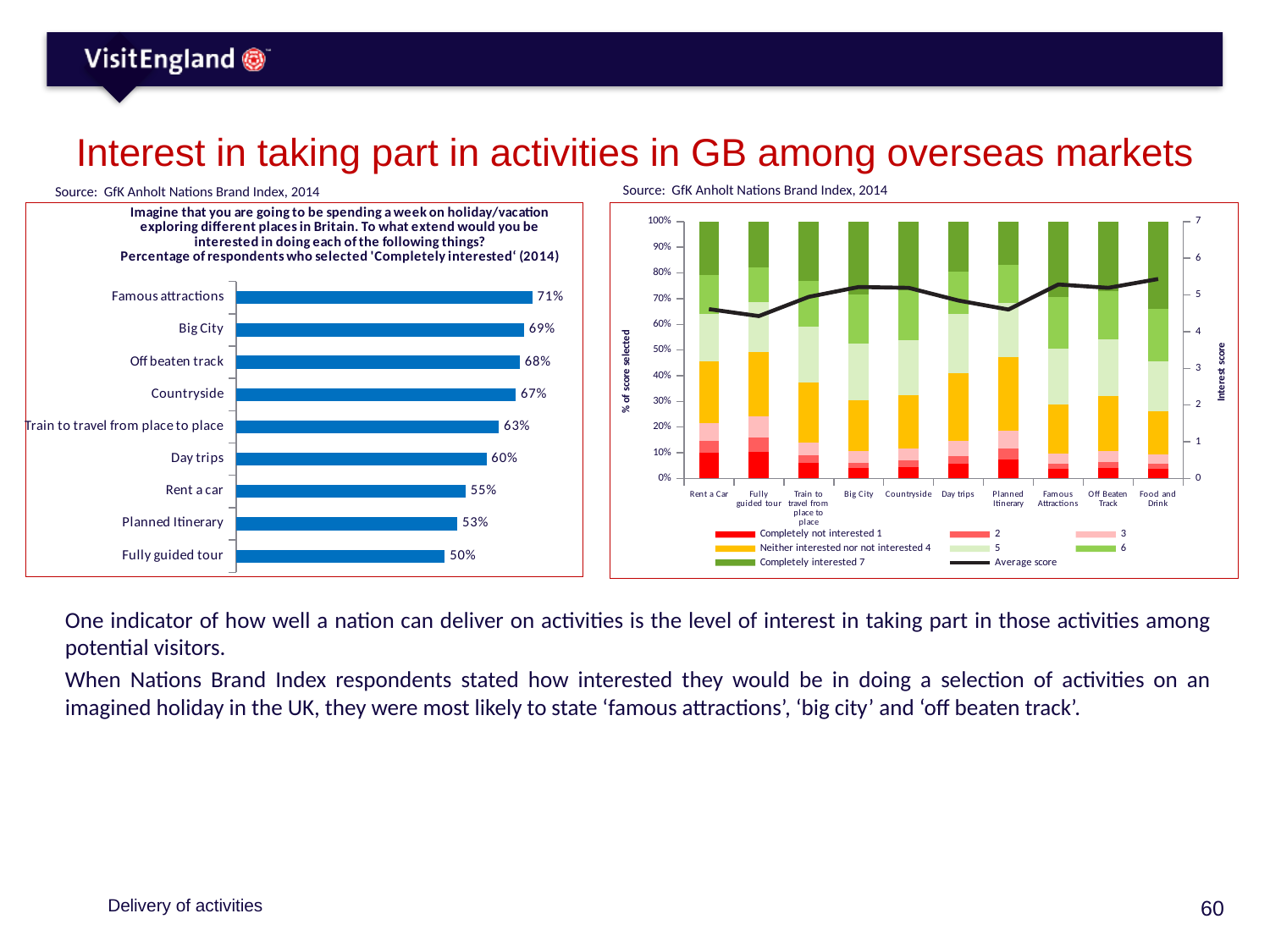
On the left chart, which is larger: the value for Day trips or the value for Planned Itinerary? Day trips On the right chart, is the Average score for Food and Drink greater or less than 5? greater On the left chart, what is the value for Train to travel from place to place? 63% On the left chart, what percentage of respondents selected 'Completely interested' for Famous attractions? 71% On the right chart, is the Average score for Fully guided tour greater or less than 5? less What type of chart is the left chart? Bar chart On the left chart, what is the value for Fully guided tour? 50% On the left chart, what is the difference between the values for Big City and Rent a car? 14 percentage points How many entries does the legend of the right chart list? 8 On the left chart, which activity has the highest percentage of 'Completely interested' respondents? Famous attractions How many activities are listed on the left chart? 9 On the left chart, which activity has the lowest percentage? Fully guided tour